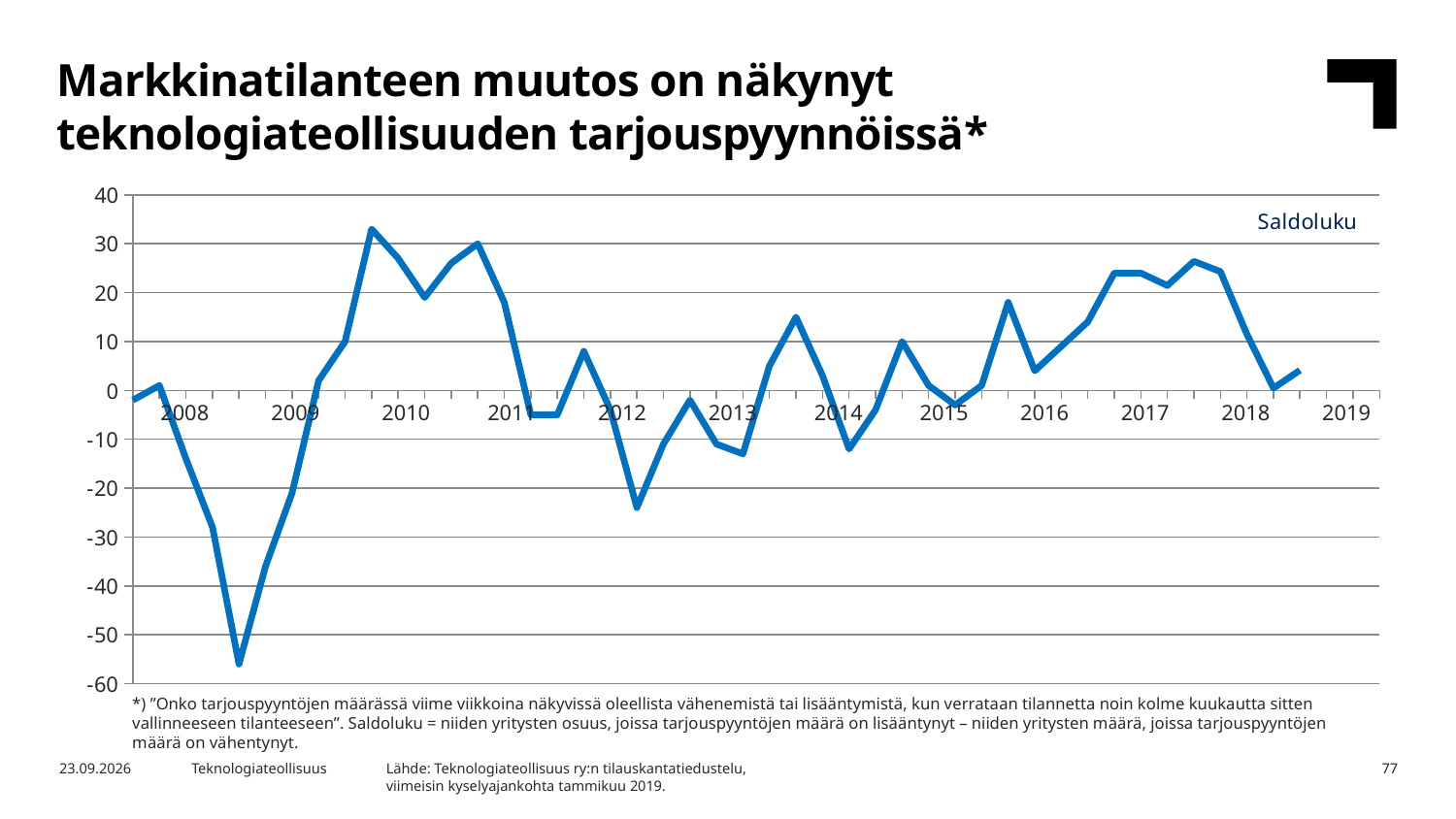
How many series does the chart show? 1 What kind of chart is shown on the slide? line chart In which year does the line reach its lowest point? 2009 Do the values rise or fall between the start of 2018 and the end of 2018? fall Is the last plotted value, in early 2019, greater or less than 0? greater Is the lowest value of the line, reached in 2009, greater or less than -50? less What is the name of the series plotted on the chart? Saldoluku Do the values rise or fall between the start of 2009 and the start of 2010? rise How many year labels are shown on the x axis? 12 What is the highest value shown on the y axis? 40